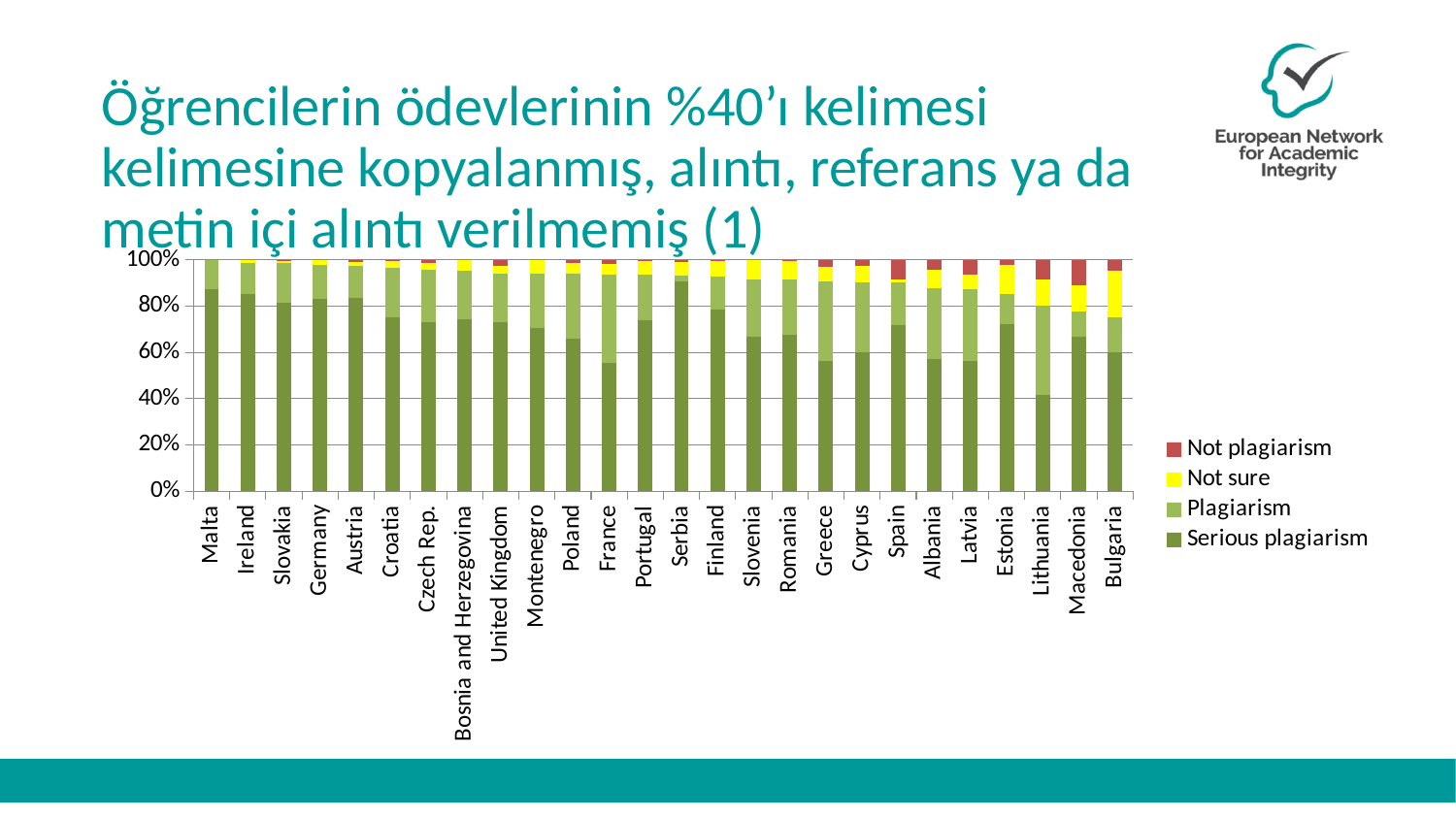
Which legend entry is shown in red? Not plagiarism What kind of chart is shown on the slide? stacked bar chart Which has the larger Serious plagiarism share, Lithuania or Macedonia? Macedonia How many countries are shown on the x axis of the chart? 26 Is the Serious plagiarism value for Lithuania greater or less than 60%? less Which legend entry is shown in yellow? Not sure Is the Serious plagiarism value for Germany greater or less than 80%? greater Is the Serious plagiarism value for Malta greater or less than 80%? greater Which country has the lowest share of Serious plagiarism? Lithuania How many series does the chart legend list? 4 Which has the larger Serious plagiarism share, Malta or Lithuania? Malta